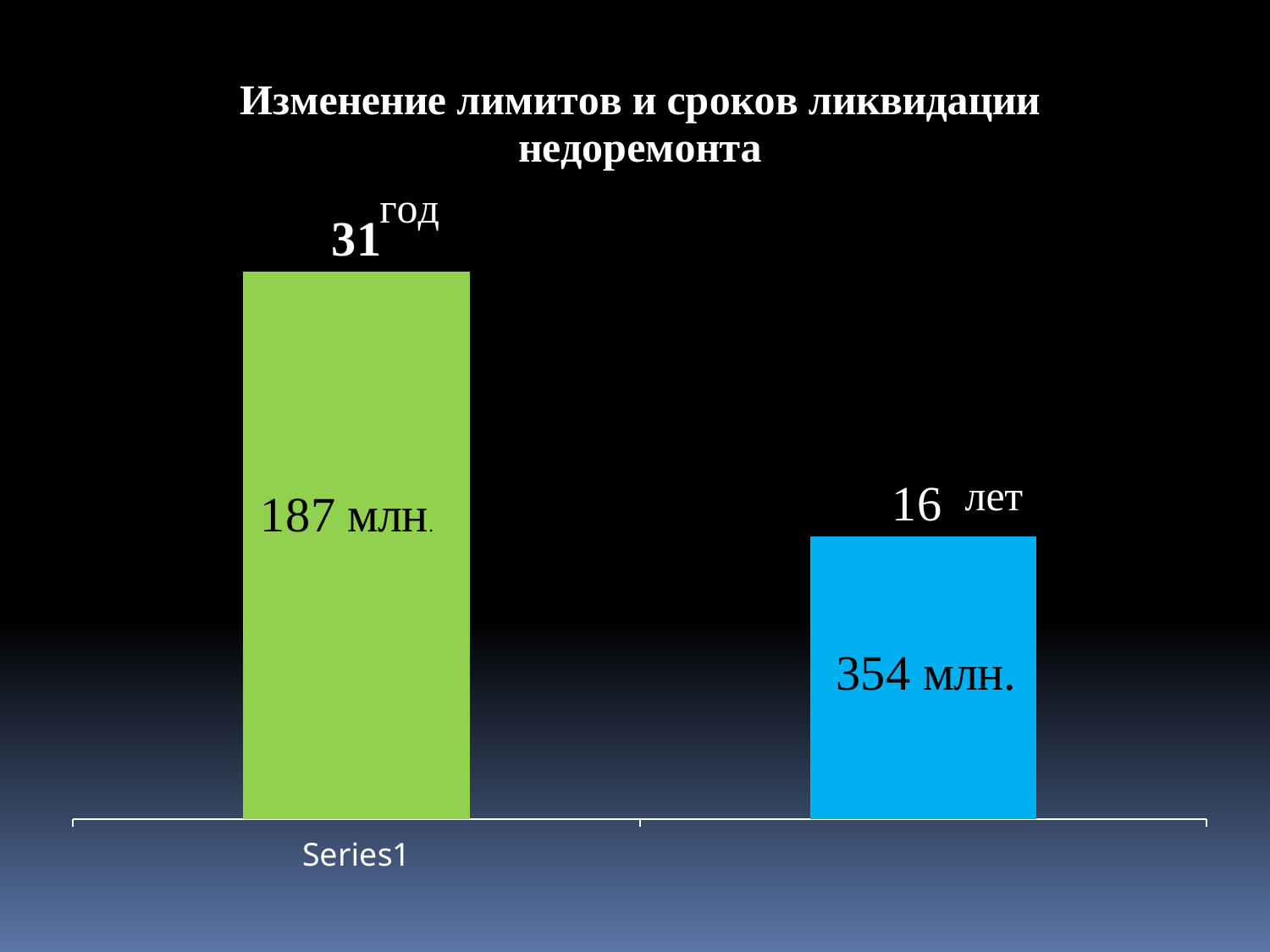
What kind of chart is shown on the slide? bar chart How many years are shown above the blue (right) bar? 16 лет What value is printed inside the blue (right) bar? 354 млн. How many bars are plotted in the chart? 2 What is the title of the chart? Изменение лимитов и сроков ликвидации недоремонта How many years are shown above the green (left) bar? 31 год Which bar has the larger million value printed on it, the green or the blue? blue What category label is shown on the x axis under the left bar? Series1 What is the difference between the million values printed on the blue bar (354 млн.) and the green bar (187 млн.)? 167 млн. Which bar is taller, the green one or the blue one? green What is the difference in years between the green bar (31) and the blue bar (16)? 15 What value is printed inside the green (left) bar? 187 млн.